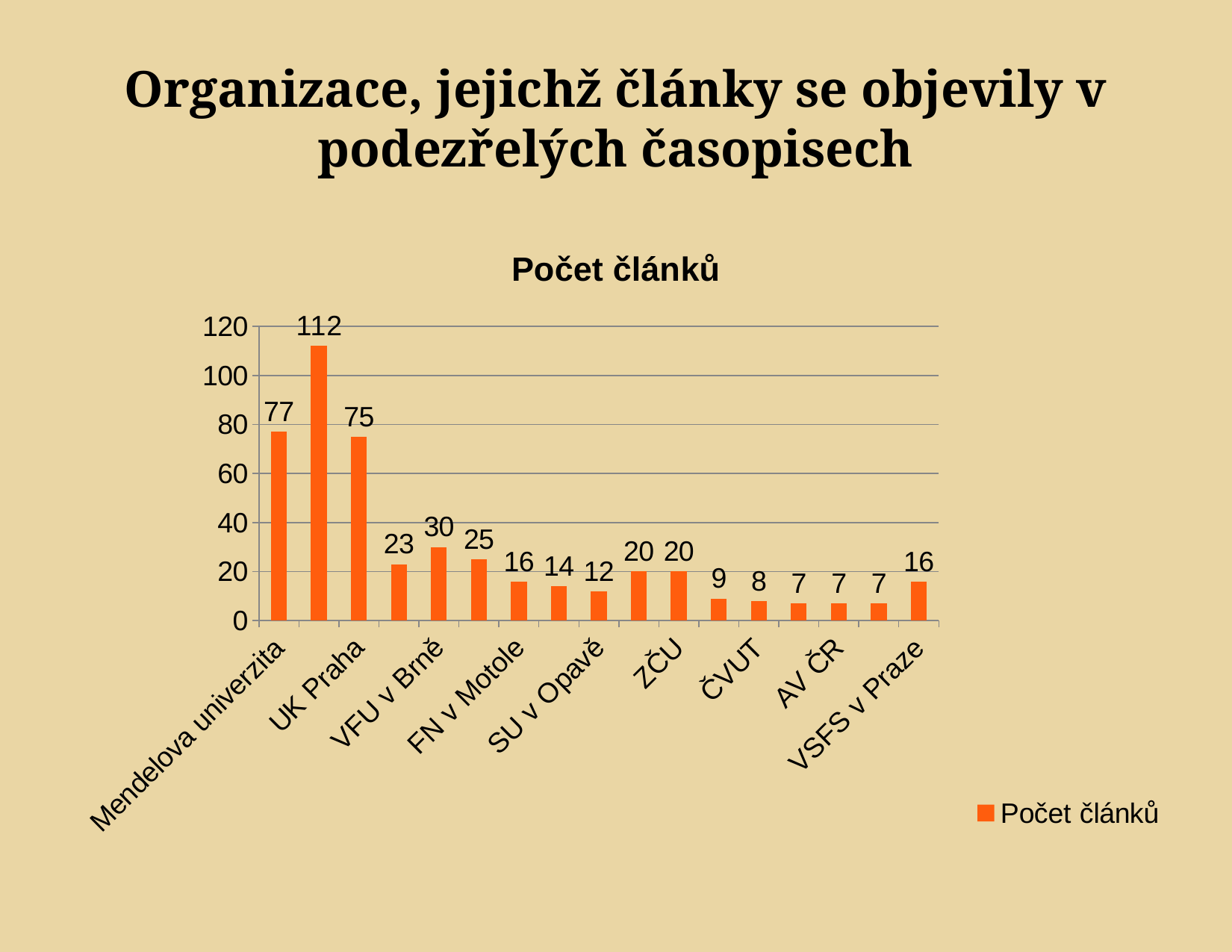
What is the value for UK Praha? 75 What is the difference between the values for Mendelova univerzita and UK Praha? 2 How many series does the legend list? 1 How many bars are plotted in the chart? 17 What is the value for Mendelova univerzita? 77 What is the title of the chart? Počet článků Which is larger, the value for Mendelova univerzita or the value for VSFS v Praze? Mendelova univerzita What kind of chart is shown on the slide? bar chart What is the lowest value shown in the chart? 7 Is the value for Mendelova univerzita greater or less than 60? greater What is the value for VSFS v Praze? 16 What is the highest value shown in the chart? 112